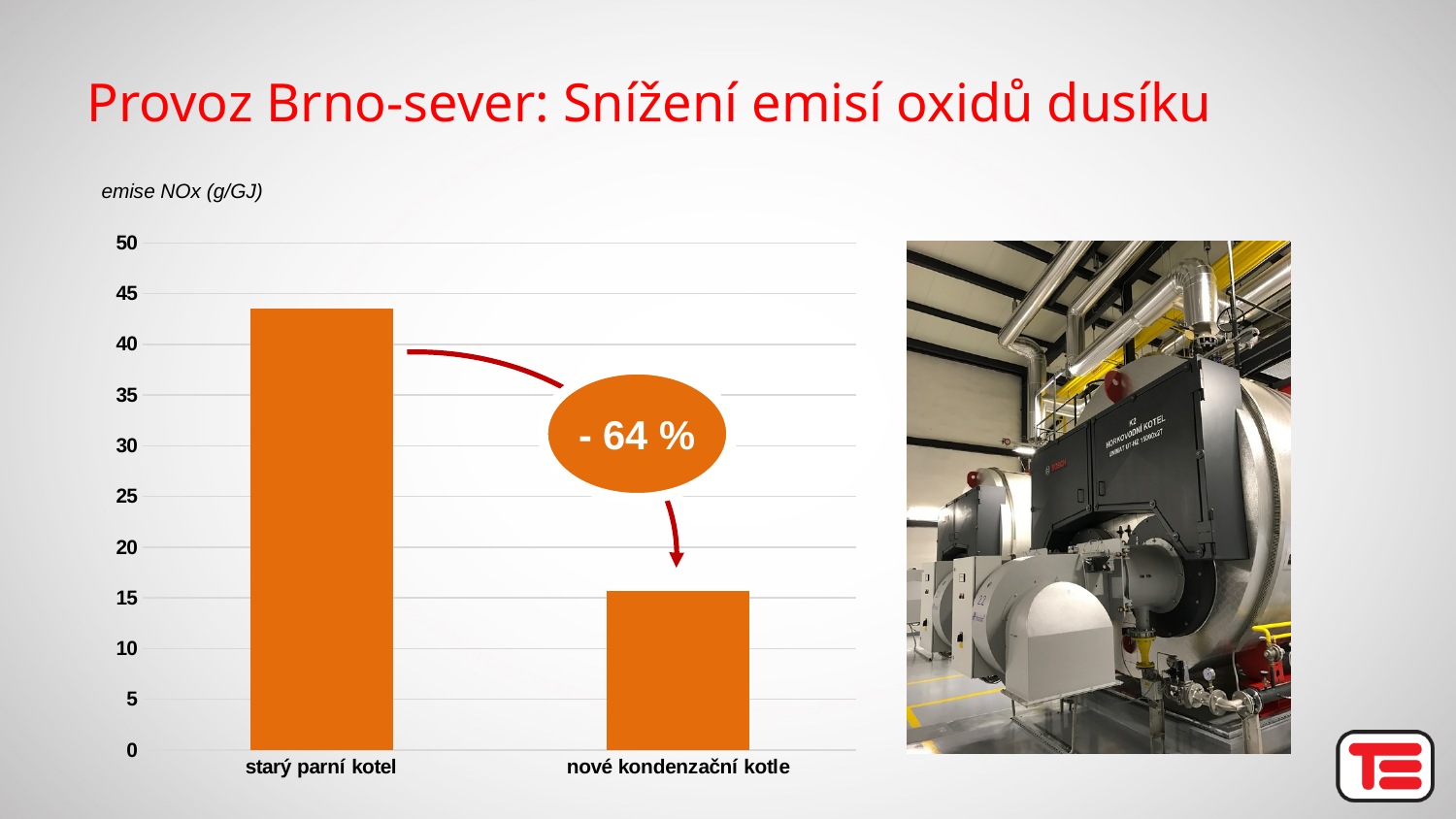
What kind of chart is shown on the slide? bar chart Which category has the highest NOx emissions in the chart? starý parní kotel Which has the larger value, starý parní kotel or nové kondenzační kotle? starý parní kotel How many categories are plotted in the chart? 2 Is the value for starý parní kotel greater or less than 45? less What unit is given for the values in the chart? g/GJ Do the values rise or fall from left to right across the categories? fall Is the value for nové kondenzační kotle greater or less than 20? less Which category has the lowest NOx emissions in the chart? nové kondenzační kotle Is the value for starý parní kotel greater or less than 40? greater What percentage change is shown in the annotation between the two bars? - 64 %